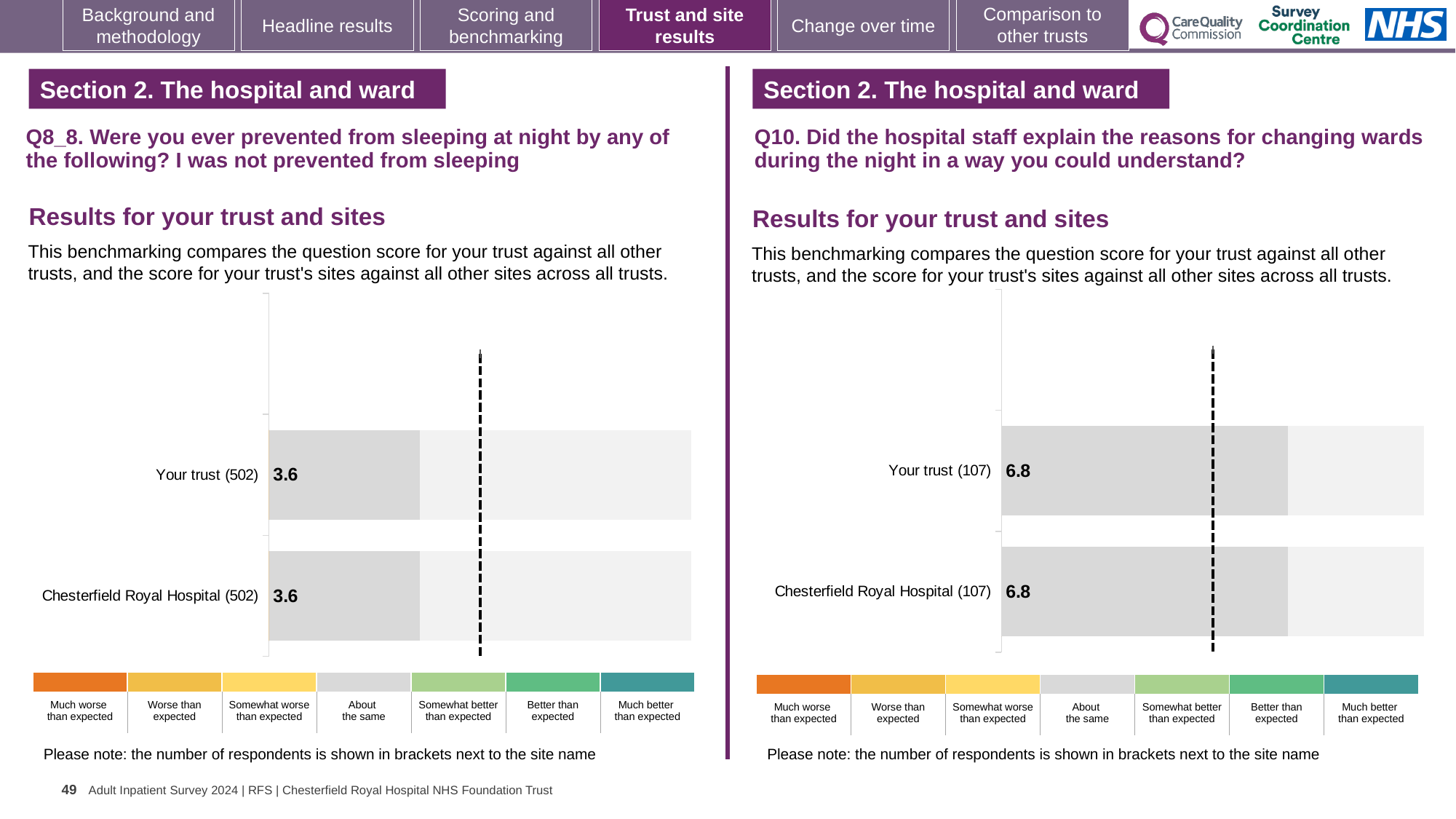
What kind of chart is used in the left chart (Q8_8)? Bar chart In the right chart (Q10), what is the difference between the score for Your trust and the score for Chesterfield Royal Hospital? 0 In the right chart (Q10), what is the score for Your trust? 6.8 In the left chart (Q8_8), what is the score for Your trust? 3.6 In the left chart (Q8_8), what is the score for Chesterfield Royal Hospital? 3.6 In the left chart (Q8_8), how many respondents are shown in brackets next to Your trust? 502 In the left chart (Q8_8), what is the difference between the score for Your trust and the score for Chesterfield Royal Hospital? 0 How many bars are plotted in the right chart (Q10)? 2 How many bars are plotted in the left chart (Q8_8)? 2 Is the score for Your trust in the right chart (Q10) larger than the score for Your trust in the left chart (Q8_8)? Yes In the right chart (Q10), how many respondents are shown in brackets next to Chesterfield Royal Hospital? 107 In the right chart (Q10), what is the score for Chesterfield Royal Hospital? 6.8